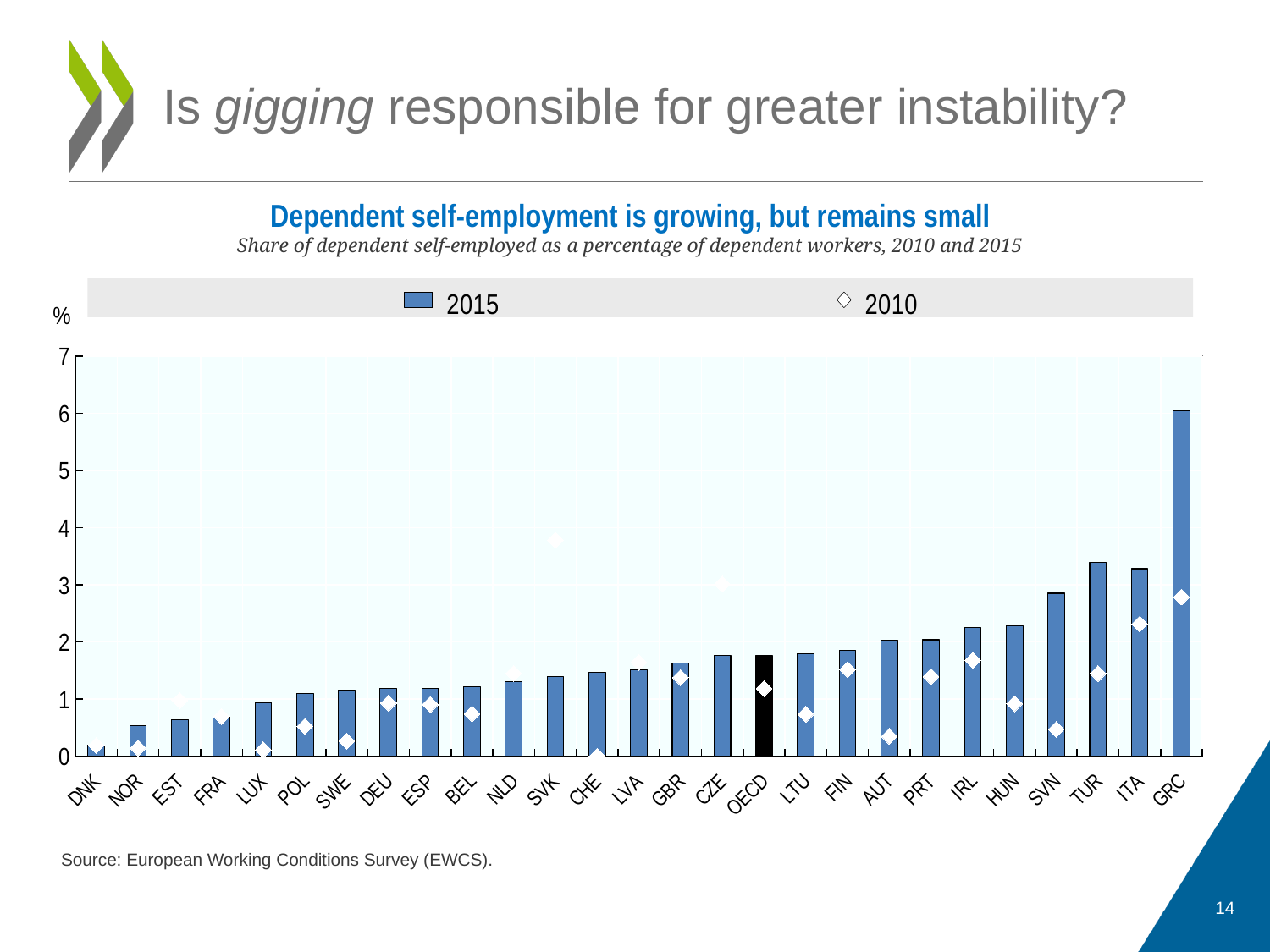
Which country has the lowest 2015 bar? DNK How many countries/categories are shown on the x axis? 27 Which country has the highest 2015 bar? GRC Which has the larger 2015 value, GRC or TUR? GRC What is the title of the chart? Dependent self-employment is growing, but remains small Do the 2015 bars generally rise or fall from left to right along the x axis? Rise Is the 2015 value for DNK greater or less than 1? less Is the 2015 value for OECD greater or less than 2? less Is the 2015 value for TUR greater or less than 3? greater How many series does the legend list? 2 What kind of chart is shown on the slide? Bar chart